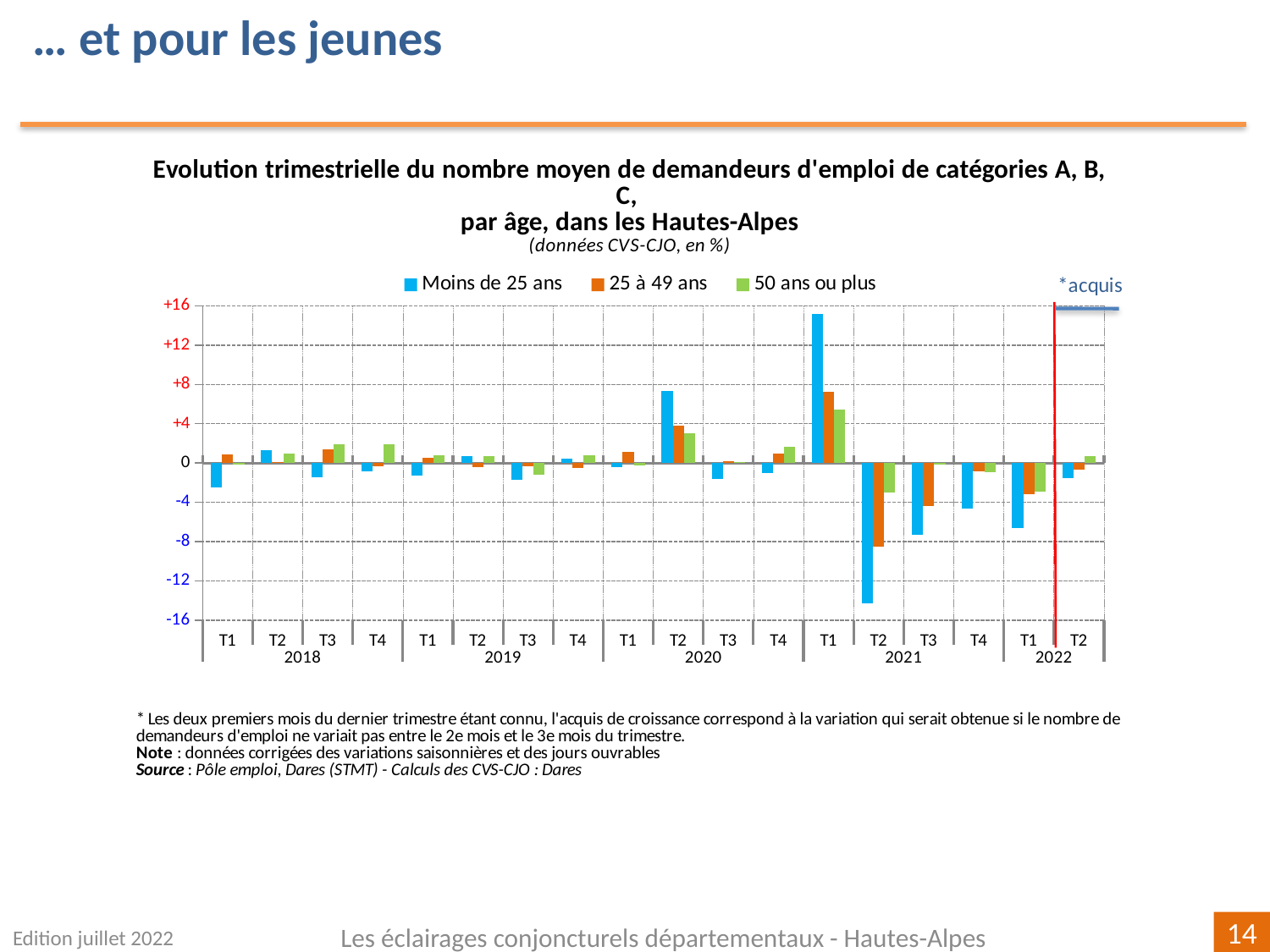
What colour represents the 'Moins de 25 ans' series? blue Is the value for '25 à 49 ans' in T2 2021 greater or less than -4? less How many quarters are shown along the x axis? 18 In which quarter is the value for 'Moins de 25 ans' lowest? T2 2021 Is the value for 'Moins de 25 ans' in T2 2021 greater or less than -12? less How many series does the legend list? 3 Is the value for 'Moins de 25 ans' in T2 2020 greater or less than +4? greater What kind of chart is shown on the slide? bar chart In T2 2021, which series has the lower value: '25 à 49 ans' or '50 ans ou plus'? 25 à 49 ans In T1 2021, which series has the larger value: 'Moins de 25 ans' or '25 à 49 ans'? Moins de 25 ans In which quarter is the value for 'Moins de 25 ans' highest? T1 2021